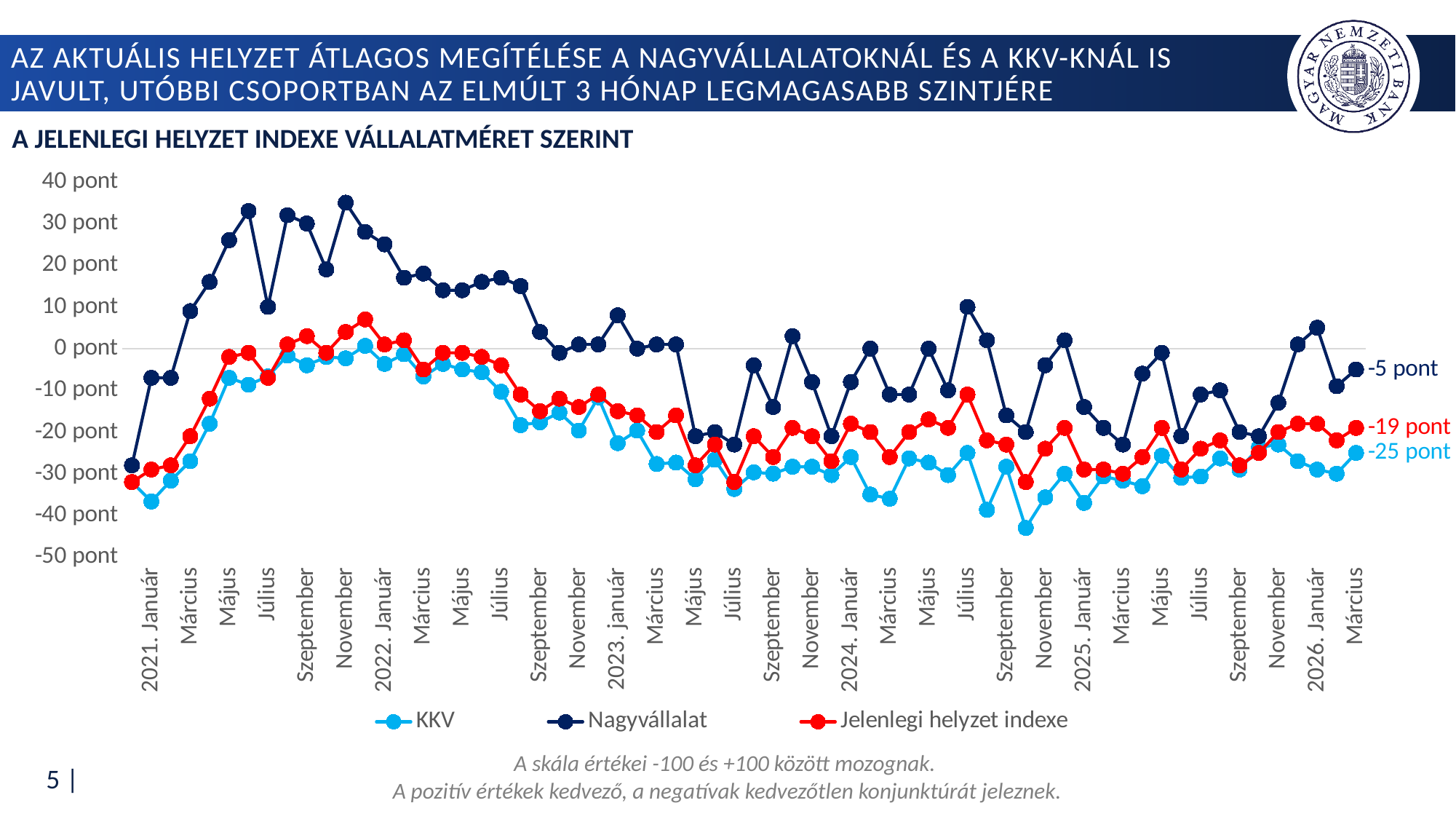
Does the Nagyvállalat series rise or fall between January 2021 and May 2021? Rise What is the value of the KKV series at the last point (March 2026)? -25 pont At the last point (March 2026), how many points higher is the Nagyvállalat value than the KKV value? 20 pont What is the value of the Jelenlegi helyzet indexe series at the last point (March 2026)? -19 pont Which series has the highest value at the last point (March 2026)? Nagyvállalat At the last point (March 2026), which series has the higher value: KKV or Nagyvállalat? Nagyvállalat What is the title of the chart? A JELENLEGI HELYZET INDEXE VÁLLALATMÉRET SZERINT What kind of chart is shown on the slide? Line chart At the last point (March 2026), what is the difference between the Nagyvállalat value and the Jelenlegi helyzet indexe value? 14 pont What is the value of the Nagyvállalat series at the last point (March 2026)? -5 pont How many series does the legend list? 3 Is the value for Nagyvállalat in November 2021 greater or less than 30 pont? greater